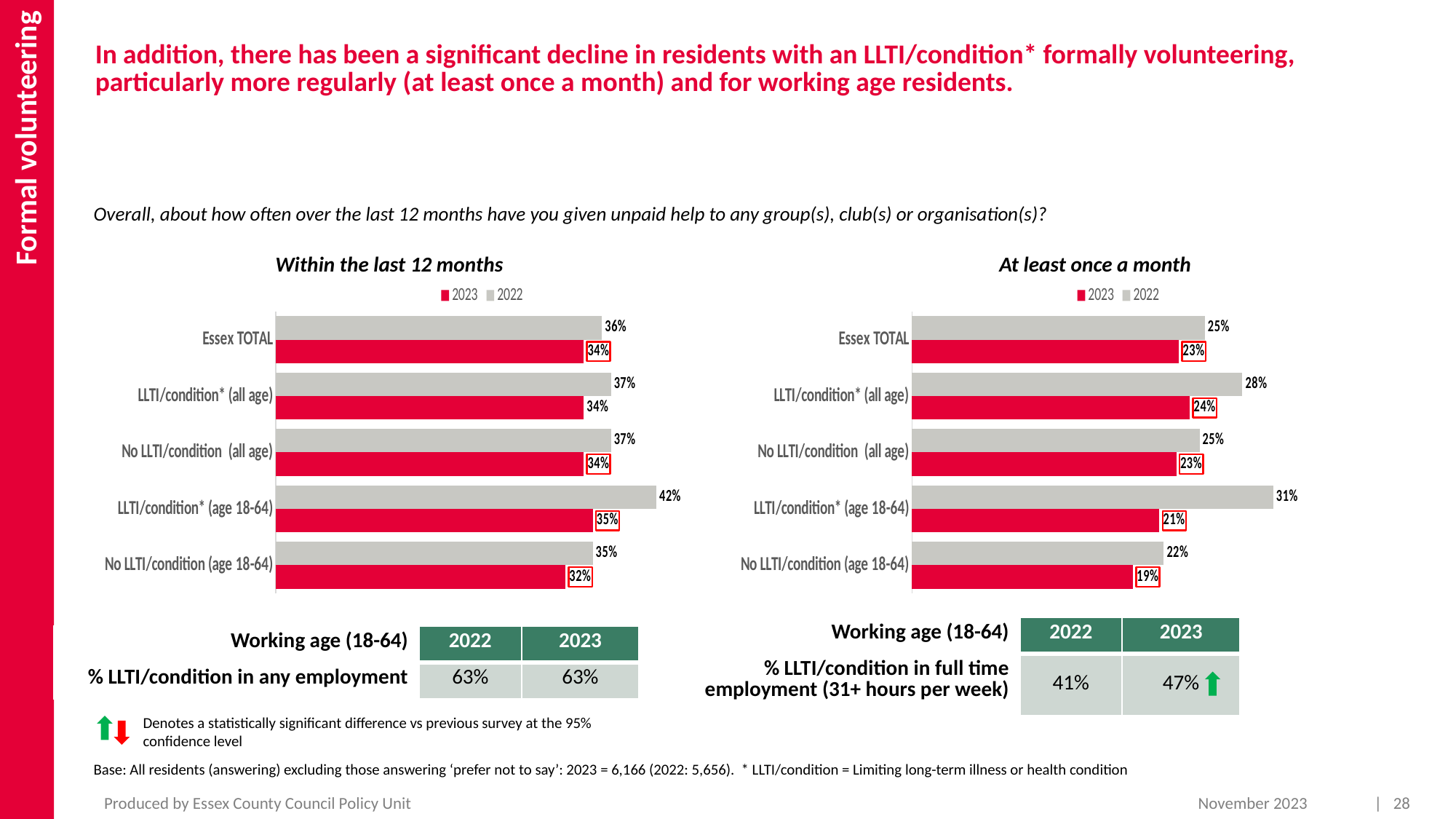
In the 'Within the last 12 months' chart, which is larger for Essex TOTAL: the 2022 value or the 2023 value? 2022 What type of chart is the 'Within the last 12 months' chart? Bar chart In the 'Within the last 12 months' chart, what is the difference between the 2022 and 2023 values for LLTI/condition* (age 18-64)? 7 percentage points In the 'Within the last 12 months' chart, what is the 2023 value for No LLTI/condition (age 18-64)? 32% In the 'Within the last 12 months' chart, what is the 2022 value for LLTI/condition* (age 18-64)? 42% How many series does the legend of the 'Within the last 12 months' chart list? 2 In the 'At least once a month' chart, what is the 2022 value for LLTI/condition* (all age)? 28% In the 'At least once a month' chart, which category has the lowest 2023 value? No LLTI/condition (age 18-64) How many categories are shown in the 'At least once a month' chart? 5 In the 'At least once a month' chart, what is the difference between the 2022 and 2023 values for LLTI/condition* (age 18-64)? 10 percentage points In the 'At least once a month' chart, what is the 2023 value for LLTI/condition* (age 18-64)? 21% In the 'At least once a month' chart, which category has the highest 2022 value? LLTI/condition* (age 18-64)